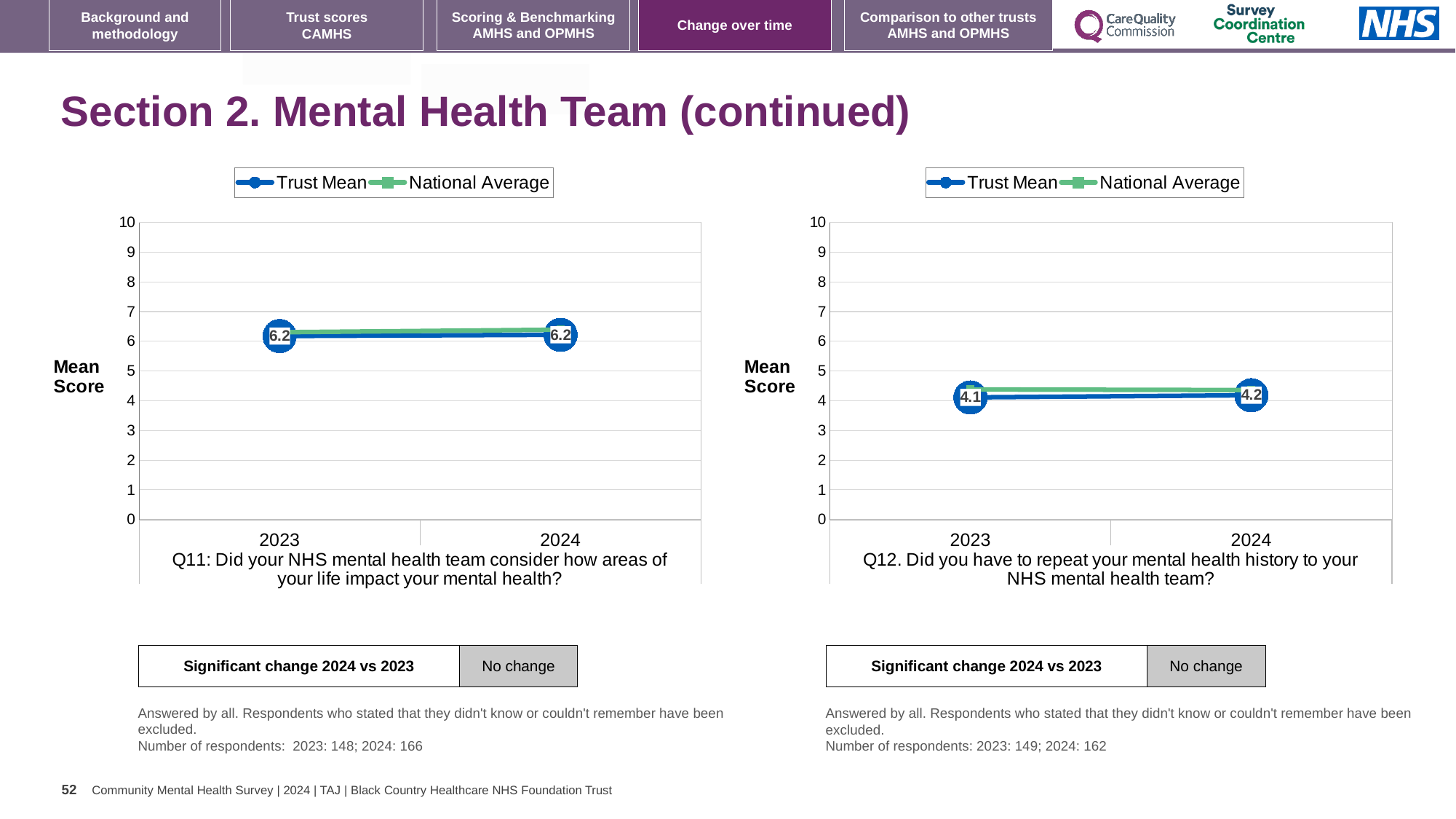
What kind of chart is the left chart (Q11)? Line chart In the right chart (Q12), which year has the higher Trust Mean, 2023 or 2024? 2024 In the left chart (Q11), what is the Trust Mean for 2024? 6.2 How many years are plotted on the x axis of the left chart (Q11)? 2 In the left chart (Q11), what is the Trust Mean for 2023? 6.2 In the left chart (Q11), is the National Average for 2024 greater or less than 5? greater What is the y-axis label of the right chart (Q12)? Mean Score In the right chart (Q12), is the National Average for 2023 greater or less than 5? less In the right chart (Q12), what is the difference between the Trust Mean for 2024 and for 2023? 0.1 In the right chart (Q12), what is the Trust Mean for 2024? 4.2 In the right chart (Q12), what is the Trust Mean for 2023? 4.1 How many series does the legend of the right chart (Q12) list? 2